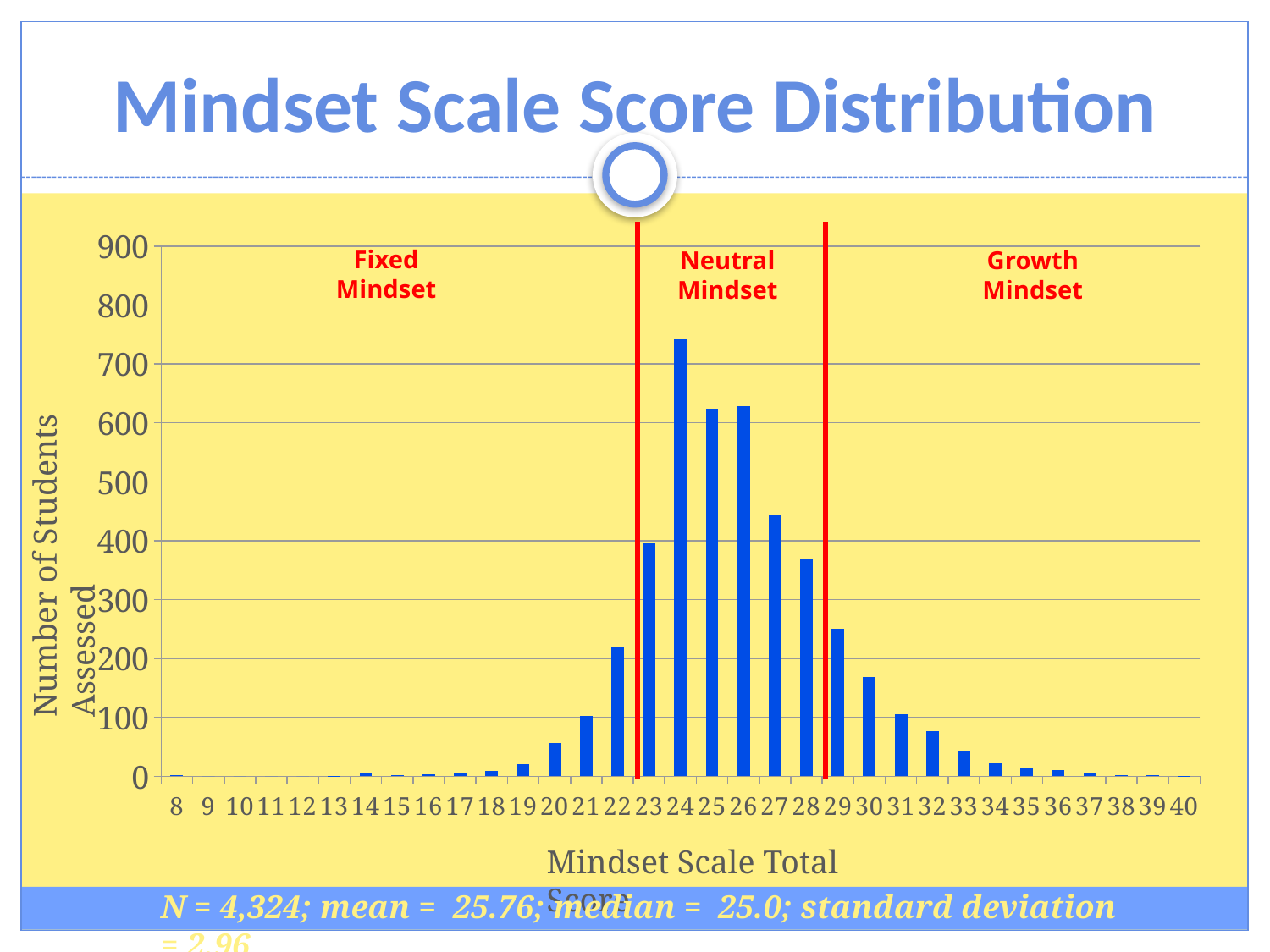
Is the number of students with a score of 28 greater or less than 400? less What kind of chart is shown on the slide? Bar chart Is the number of students with a score of 30 greater or less than 200? less Which score has more students assessed, 24 or 25? 24 How many score categories are shown along the x axis? 33 Do the bar values rise or fall as the score increases from 24 to 40? Fall What is the title of the vertical axis? Number of Students Assessed Is the number of students with a score of 27 greater or less than 400? greater Which Mindset Scale Total Score has the highest number of students assessed? 24 Which score has more students assessed, 27 or 28? 27